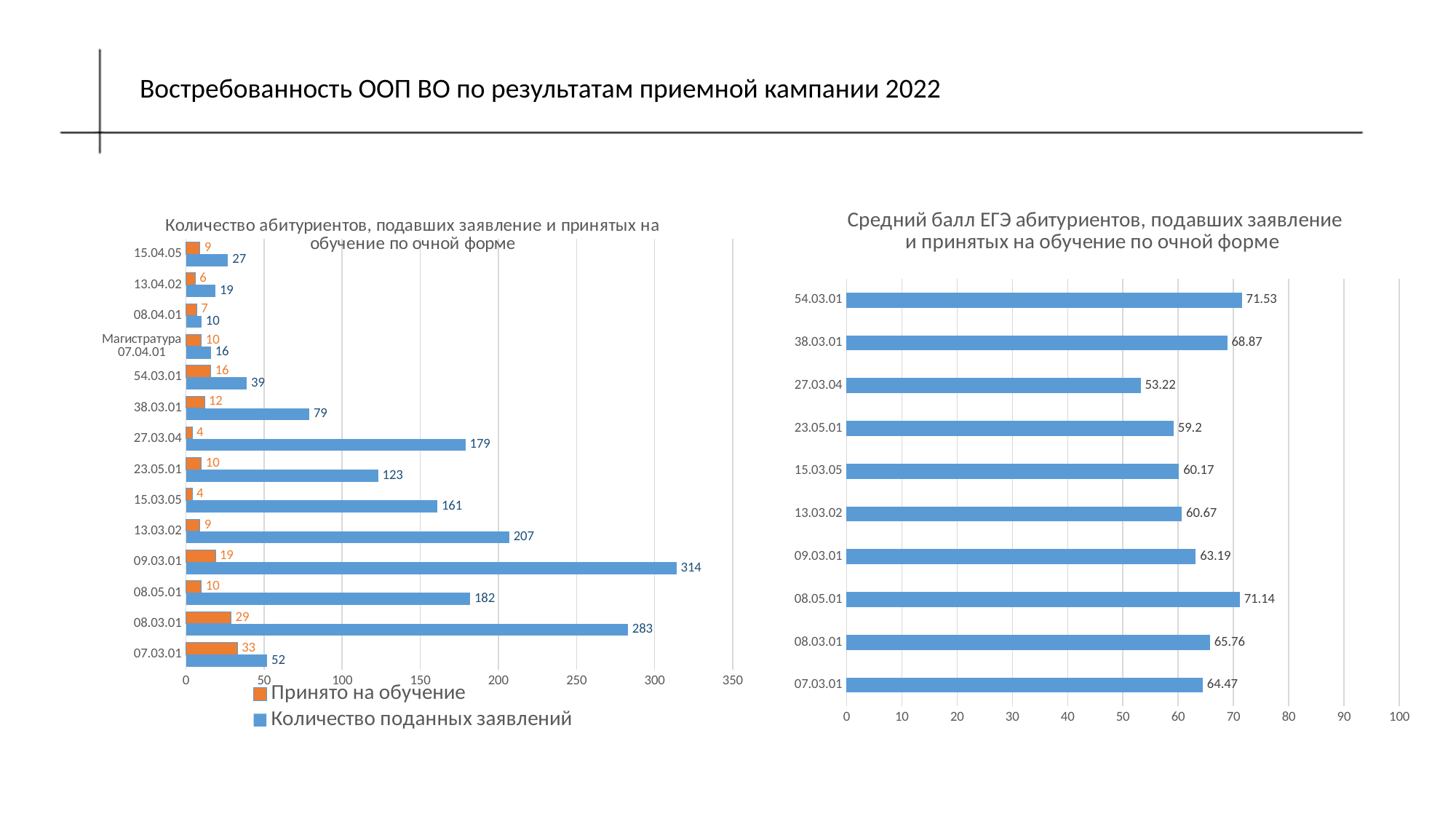
In the left chart, which is larger: the number of submitted applications for 27.03.04 or for 13.03.02? 13.03.02 How many categories are shown in the right chart? 10 How many categories are shown in the left chart? 14 In the left chart, how many students were admitted (Принято на обучение) for 07.03.01? 33 What type of chart is the right chart? Bar chart In the right chart, what is the difference between the average ЕГЭ scores of 38.03.01 and 23.05.01? 9.67 In the left chart, what is the difference between the number of submitted applications and the number admitted for 08.03.01? 254 In the right chart, which category has the lowest average ЕГЭ score? 27.03.04 In the left chart, which category has the highest number of submitted applications? 09.03.01 In the right chart, what is the average ЕГЭ score for 54.03.01? 71.53 In the left chart, how many applications (Количество поданных заявлений) were submitted for 09.03.01? 314 How many series does the legend of the left chart list? 2